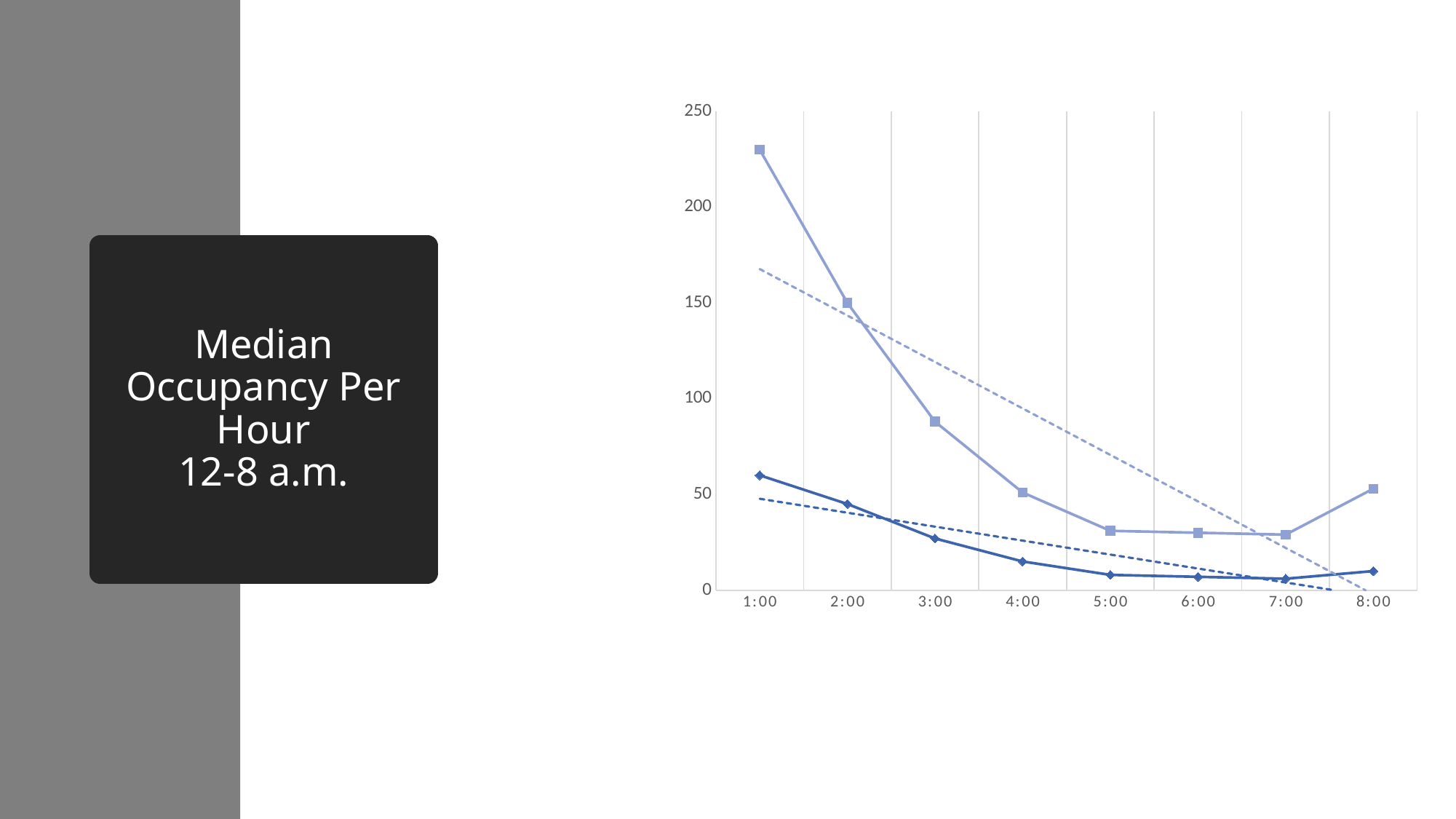
What kind of chart is shown on the slide? line chart Is the value of the light blue square-marker line at 3:00 greater or less than 100? less What is the highest value labelled on the chart's vertical axis? 250 Is the value of the dark blue diamond-marker line at 1:00 greater or less than 50? greater What is the title shown next to the chart? Median Occupancy Per Hour 12-8 a.m. How many time points are labelled along the x axis of the chart? 8 Is the value of the light blue square-marker line at 1:00 greater or less than 200? greater Which is larger for the light blue square-marker line: the value at 1:00 or the value at 8:00? 1:00 At which time does the dark blue diamond-marker line reach its highest value? 1:00 At which time does the light blue square-marker line reach its highest value? 1:00 Do the values of the light blue square-marker line rise or fall from 1:00 to 5:00? fall